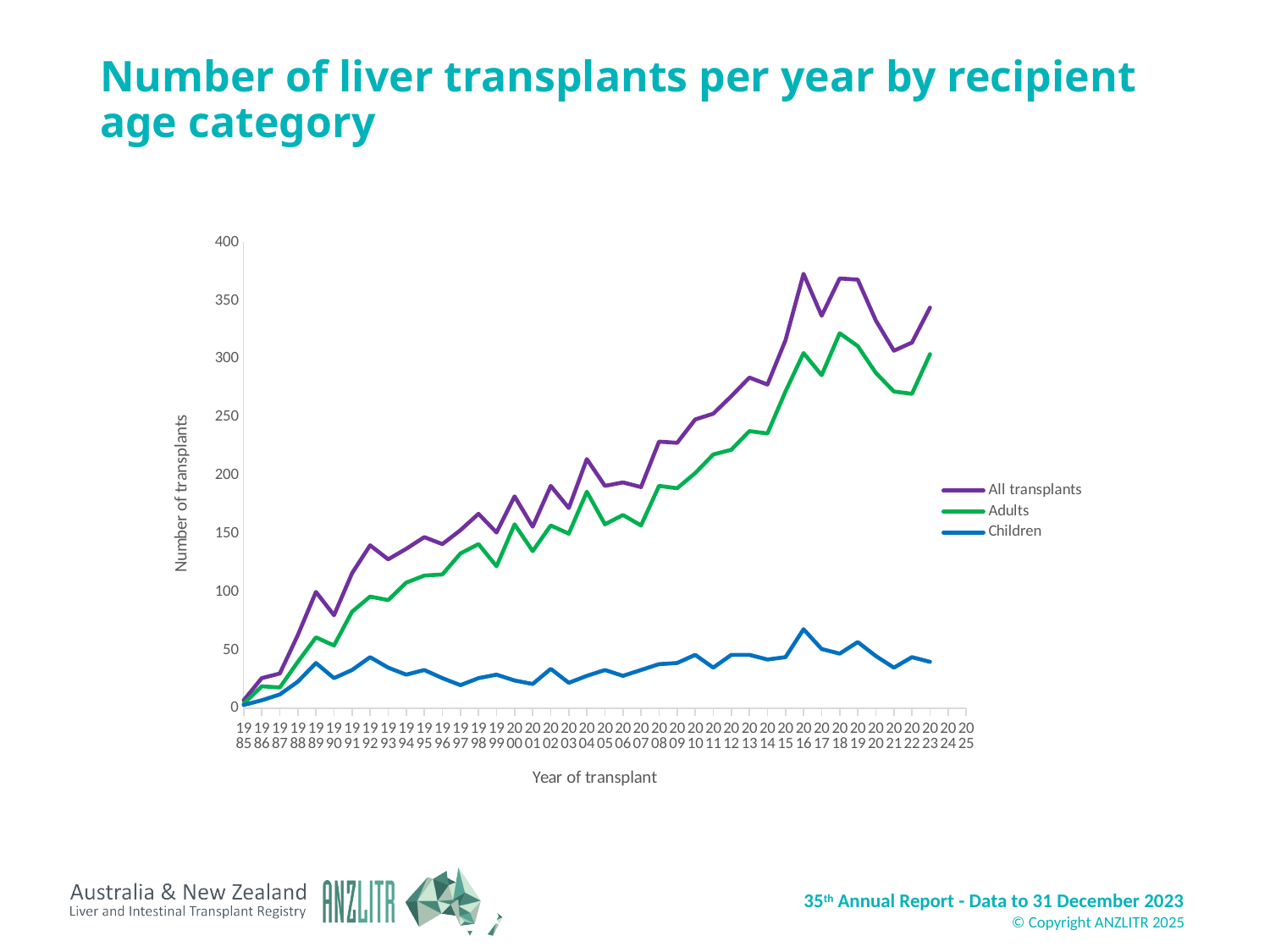
Is the value for All transplants in 2016 greater or less than 350? greater In which year does the Children series reach its highest value? 2016 Does the All transplants series rise or fall from 2019 to 2021? Fall What kind of chart is shown on the slide? Line chart What is the title of the vertical axis? Number of transplants Is the value for All transplants in 1985 greater or less than 50? less Is the value for Adults in 2018 greater or less than 300? greater What are the three series named in the legend? All transplants, Adults, Children Does the All transplants series generally rise or fall from 1985 to 2016? Rise How many series does the legend list? 3 Which is larger for All transplants: the value in 2016 or the value in 2017? 2016